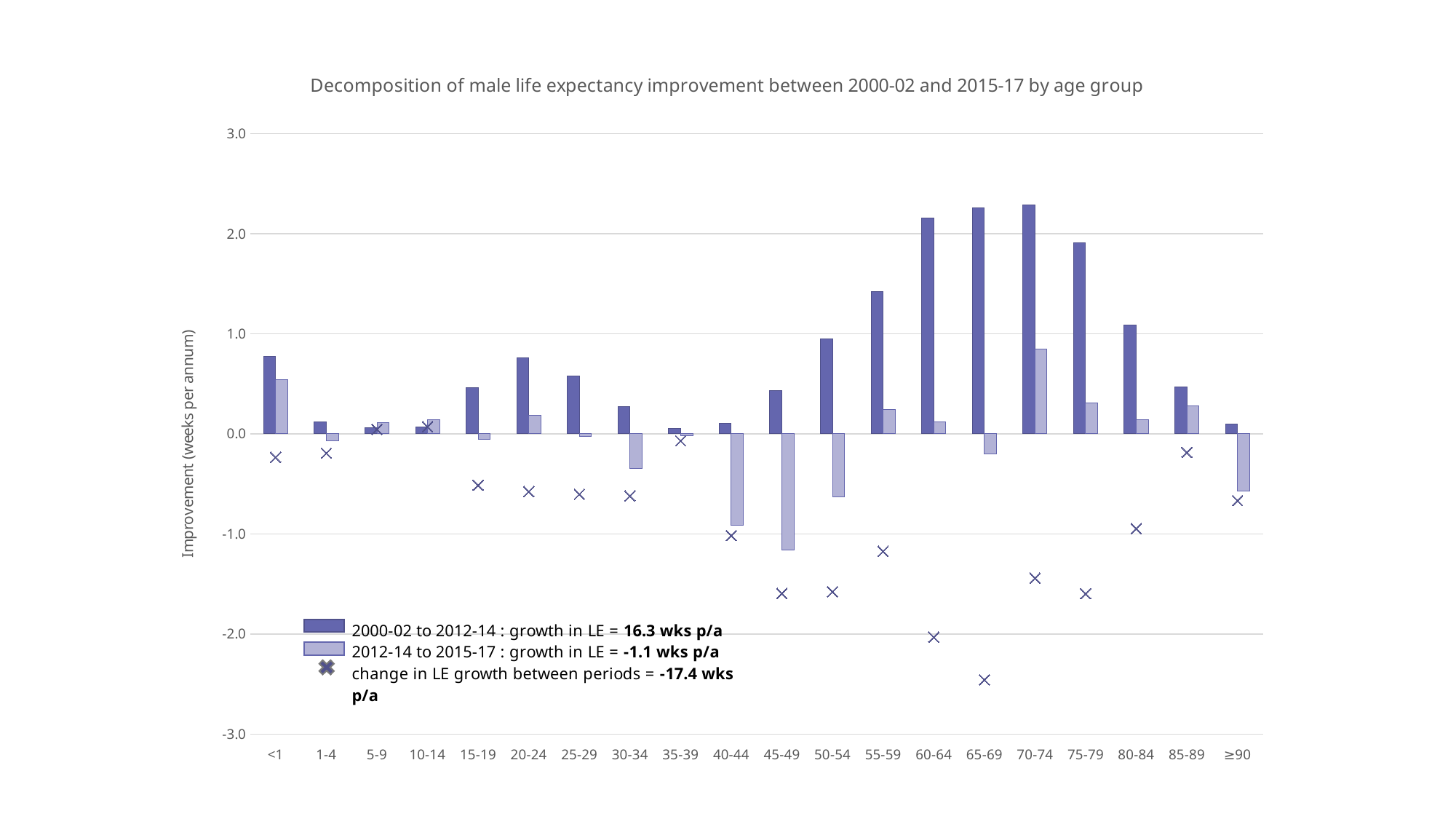
How many series does the legend list? 3 Which age group has the lowest value for the change in LE growth between periods (X markers)? 65-69 How many age groups are shown along the x axis? 20 Is the 2012-14 to 2015-17 value for the 45-49 age group greater or less than -1.0? less According to the legend, what is the growth in LE for the 2000-02 to 2012-14 period? 16.3 wks p/a Which age group has the lowest value for the 2012-14 to 2015-17 series? 45-49 Is the 2000-02 to 2012-14 value for the 60-64 age group greater or less than 2.0? greater Is the change in LE growth between periods for the 65-69 age group greater or less than -2.0? less Do the 2000-02 to 2012-14 bars rise or fall from the 40-44 age group to the 70-74 age group? rise What kind of chart is shown on the slide? bar chart For the 2000-02 to 2012-14 series, which age group has the larger value: 20-24 or 1-4? 20-24 Which age group has the highest value for the 2012-14 to 2015-17 series? 70-74